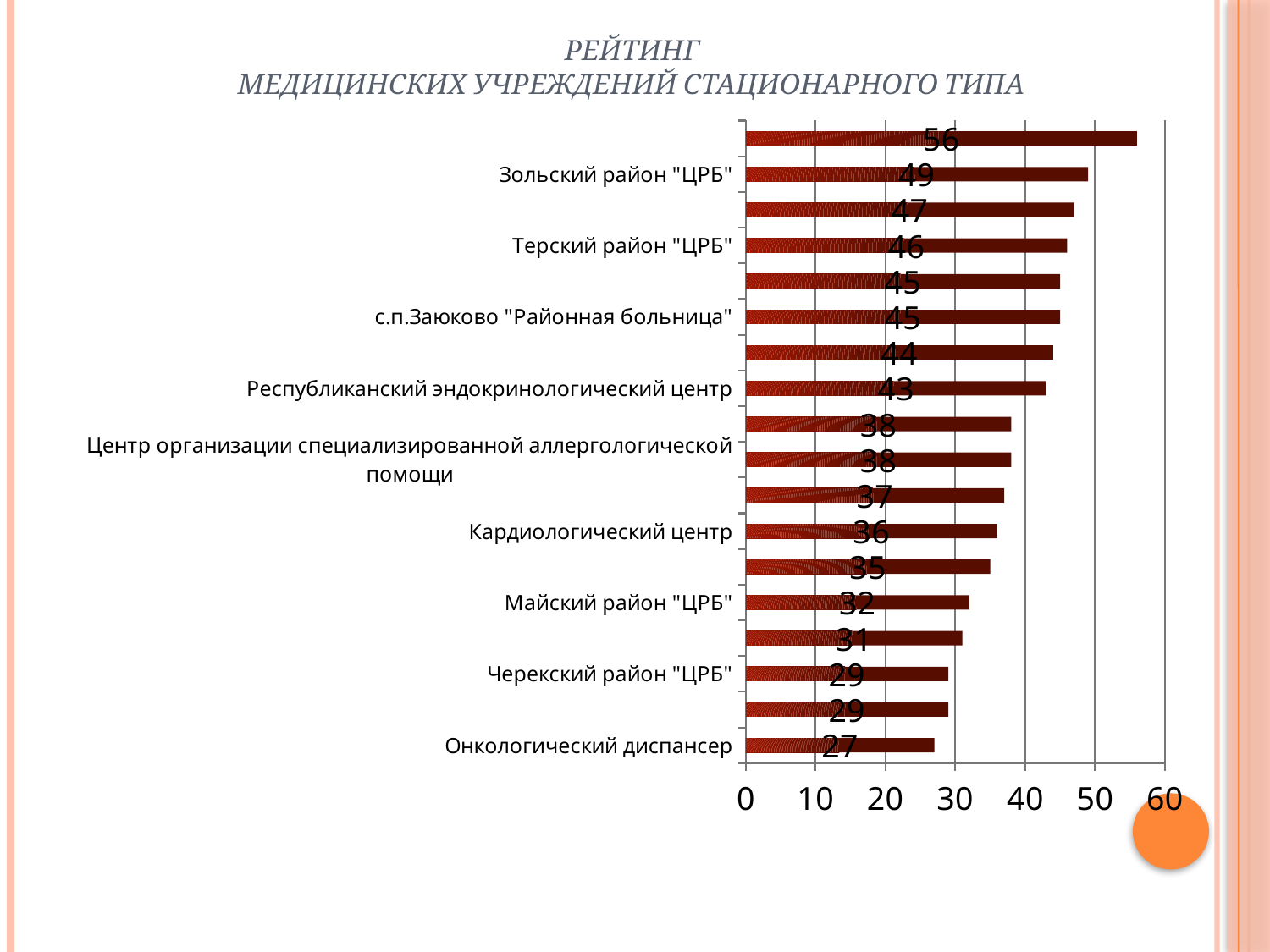
What is the highest value shown on the chart? 56 What type of chart is shown on the slide? bar chart What is the value for Терский район "ЦРБ"? 46 Which is larger, the value for Майский район "ЦРБ" or the value for Черекский район "ЦРБ"? Майский район "ЦРБ" What is the value for Кардиологический центр? 36 What is the difference between the values for Зольский район "ЦРБ" and Терский район "ЦРБ"? 3 What is the value for Онкологический диспансер? 27 How many bars are plotted on the chart? 18 Is the value for Кардиологический центр greater or less than 40? less Which labeled category has the lowest value? Онкологический диспансер What is the value for Республиканский эндокринологический центр? 43 What is the value for Зольский район "ЦРБ"? 49